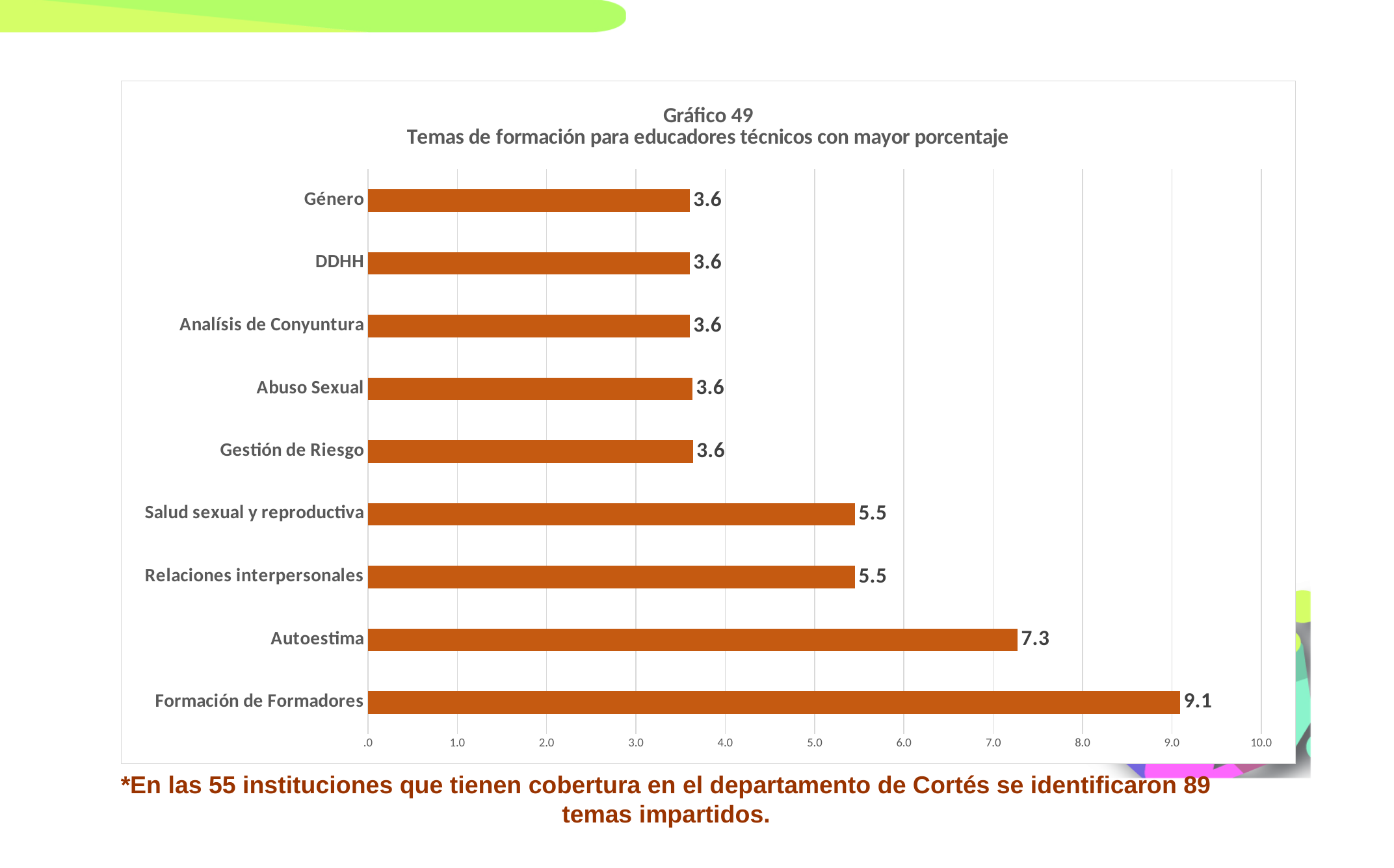
Which category has the highest value? Formación de Formadores What is the value for Formación de Formadores? 9.1 What is the difference between the values for Formación de Formadores and Autoestima? 1.8 Is the value for Formación de Formadores greater or less than 8.0? greater How many categories are shown in the chart? 9 What is the title of the chart? Gráfico 49 Temas de formación para educadores técnicos con mayor porcentaje What is the difference between the values for Autoestima and Relaciones interpersonales? 1.8 What is the value for Gestión de Riesgo? 3.6 What is the value for Autoestima? 7.3 What is the value for Salud sexual y reproductiva? 5.5 What kind of chart is shown on the slide? bar chart Which is larger, the value for Autoestima or the value for Salud sexual y reproductiva? Autoestima